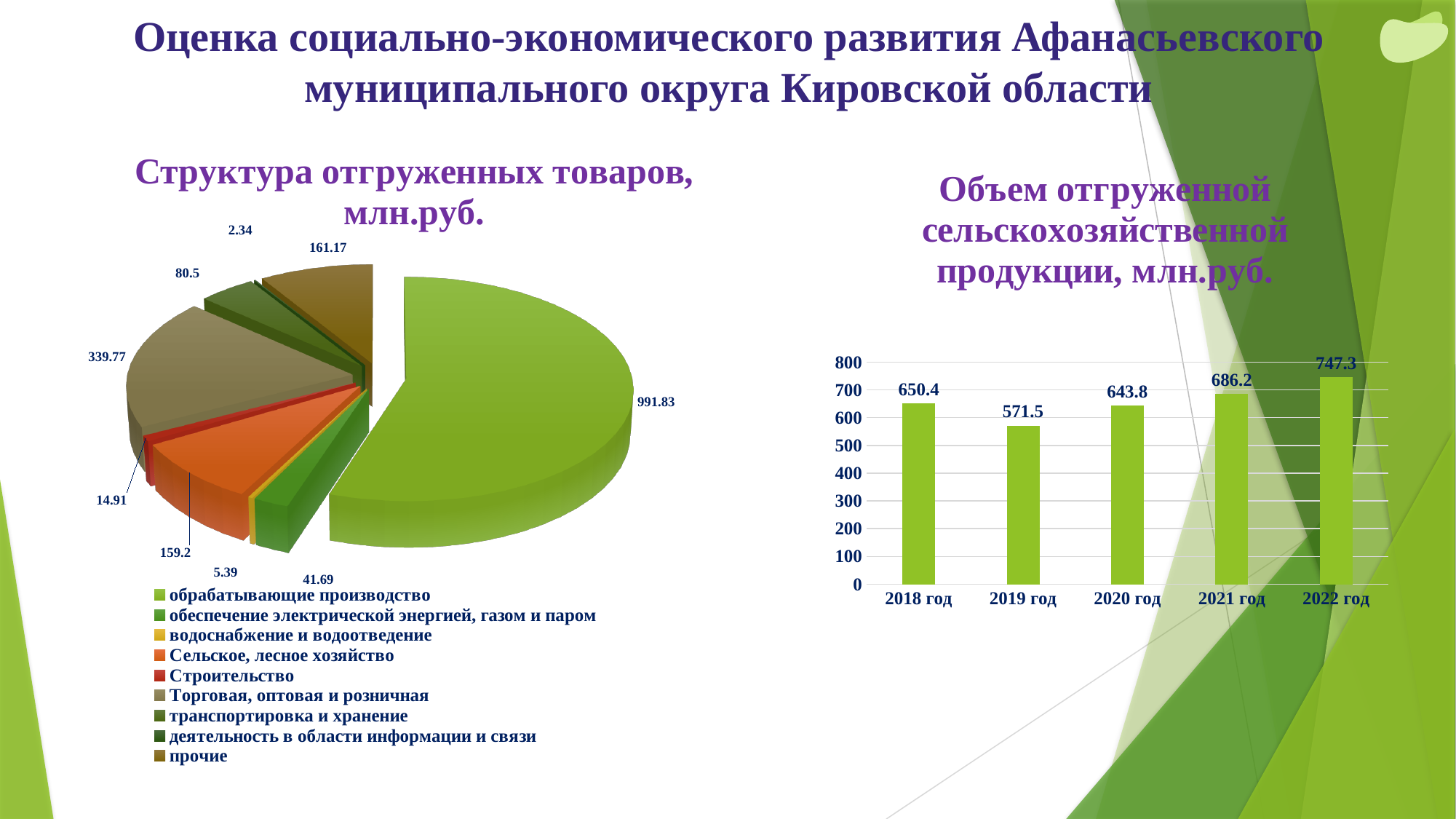
What kind of chart is 'Объем отгруженной сельскохозяйственной продукции, млн.руб.'? bar chart In the chart 'Объем отгруженной сельскохозяйственной продукции, млн.руб.', what is the value for 2022 год? 747.3 How many categories does the legend of the pie chart 'Структура отгруженных товаров, млн.руб.' list? 9 In the pie chart 'Структура отгруженных товаров, млн.руб.', which category has the largest slice? обрабатывающие производство In the chart 'Объем отгруженной сельскохозяйственной продукции, млн.руб.', which year has the lowest value? 2019 год In the chart 'Объем отгруженной сельскохозяйственной продукции, млн.руб.', which year has the highest value? 2022 год In the pie chart 'Структура отгруженных товаров, млн.руб.', what is the value for 'Сельское, лесное хозяйство'? 159.2 In the chart 'Объем отгруженной сельскохозяйственной продукции, млн.руб.', which is larger: the value for 2020 год or 2021 год? 2021 год In the pie chart 'Структура отгруженных товаров, млн.руб.', which category has the smallest slice? деятельность в области информации и связи In the chart 'Объем отгруженной сельскохозяйственной продукции, млн.руб.', how many years are shown? 5 In the chart 'Объем отгруженной сельскохозяйственной продукции, млн.руб.', what is the difference between the values for 2022 год and 2018 год? 96.9 In the chart 'Объем отгруженной сельскохозяйственной продукции, млн.руб.', do the values rise or fall from 2019 год to 2022 год? rise